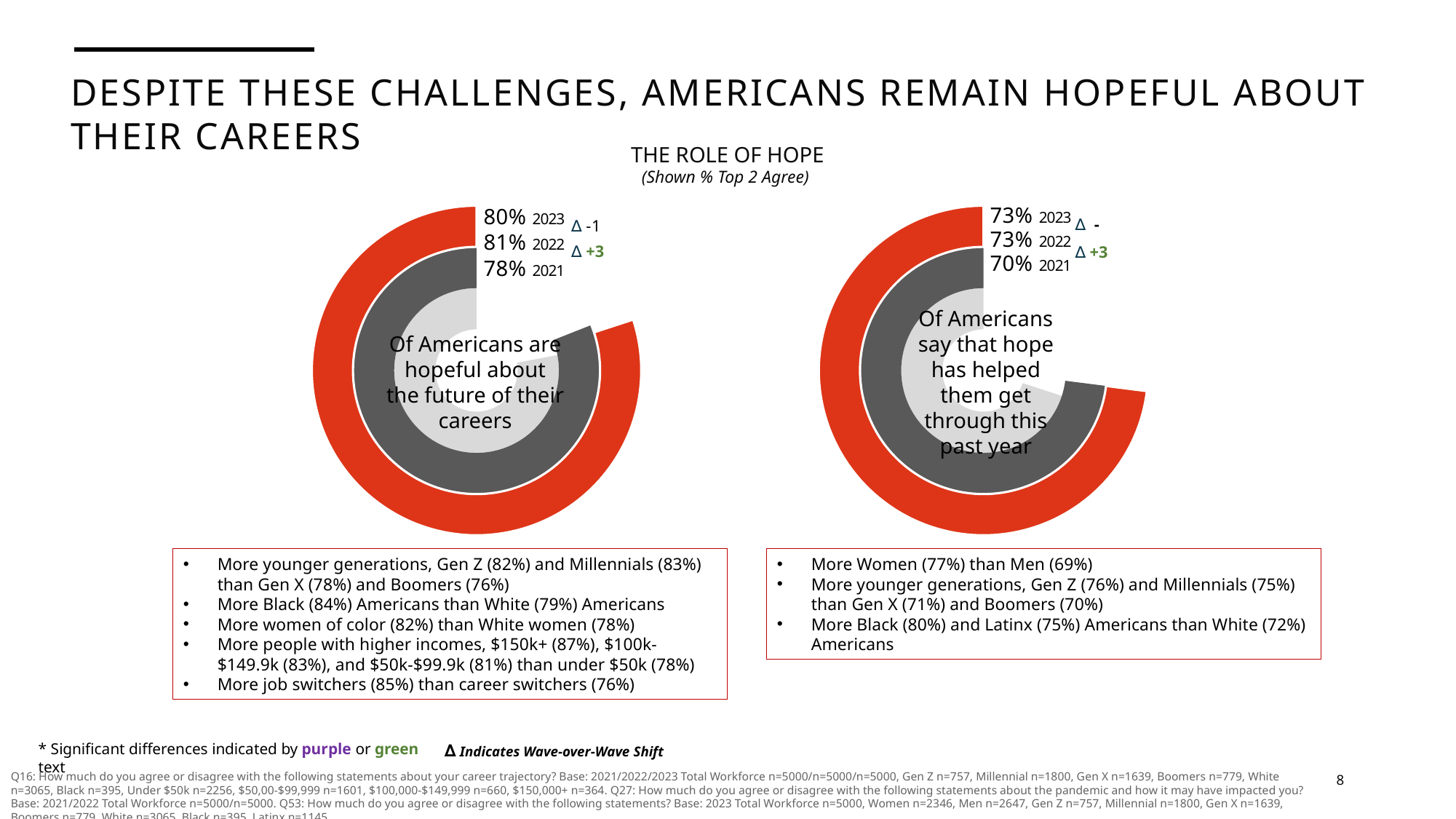
What is the title shown above the two charts? THE ROLE OF HOPE In the right chart (hope has helped them get through this past year), what is the value for 2021? 70% How many years are plotted in the left chart (Americans hopeful about the future of their careers)? 3 In the left chart (Americans hopeful about the future of their careers), what is the difference between the 2022 and 2021 values? 3 percentage points In the left chart (Americans hopeful about the future of their careers), what is the value for 2021? 78% In the right chart (hope has helped them get through this past year), which year has the lowest value? 2021 In the left chart (Americans hopeful about the future of their careers), what is the value for 2023? 80% What kind of chart is used on this slide to show the percentages by year? Doughnut (ring) chart In the right chart (hope has helped them get through this past year), what is the value for 2022? 73% In the right chart (hope has helped them get through this past year), what is the difference between the 2023 and 2021 values? 3 percentage points Which is larger: the 2023 value in the left chart (hopeful about careers) or the 2023 value in the right chart (hope helped them get through the past year)? The left chart (80%) In the left chart (Americans hopeful about the future of their careers), which year has the highest value? 2022